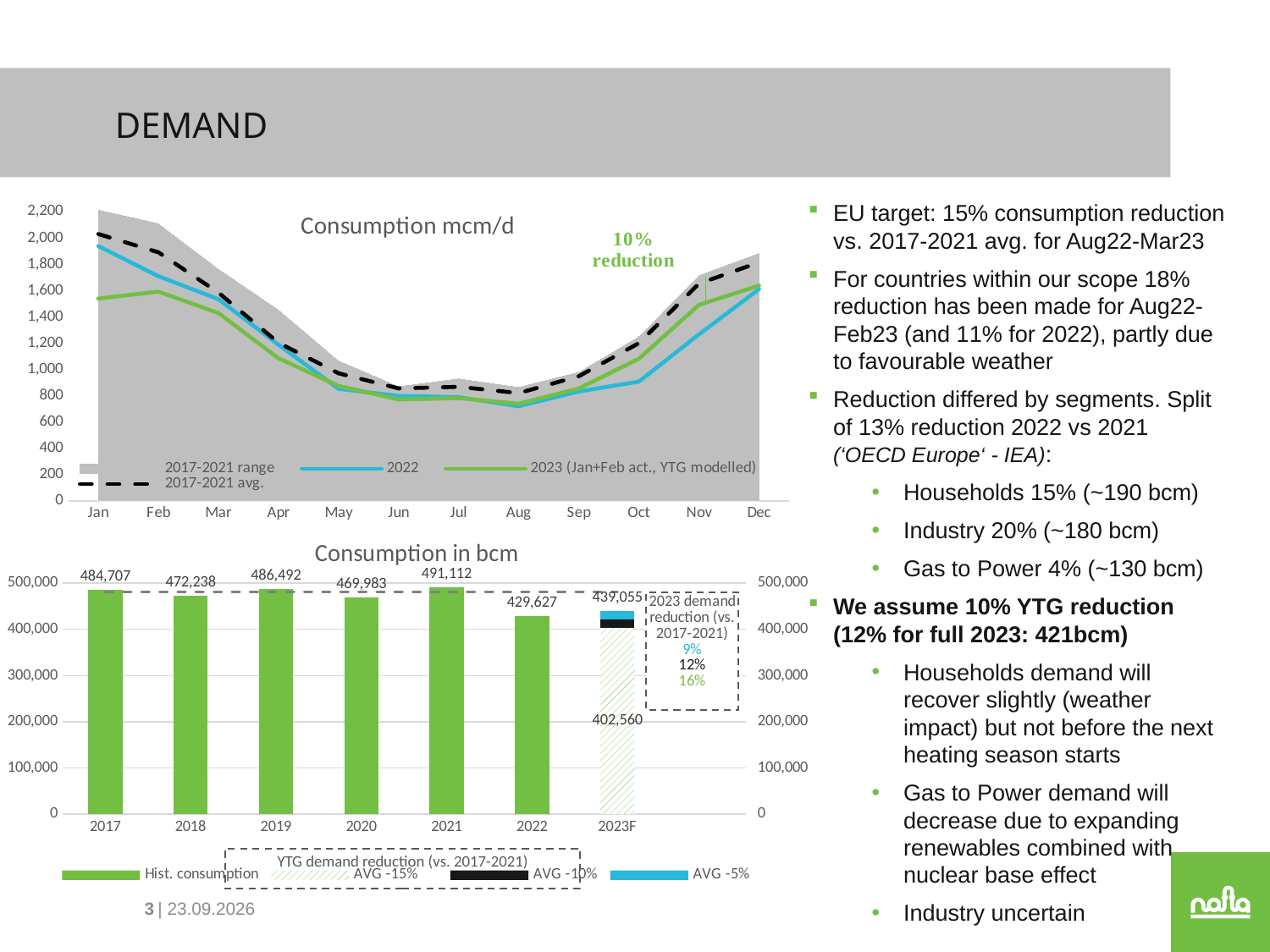
In the 'Consumption in bcm' chart, what is the value for 2022? 429,627 In the 'Consumption in bcm' chart, which year from 2017 to 2022 has the lowest consumption? 2022 How many year categories are shown on the x axis of the 'Consumption in bcm' chart? 7 In the 'Consumption mcm/d' chart, is the 2022 value for Jan greater or less than 1,800? greater In the 'Consumption in bcm' chart, what is the difference between the 2021 and 2022 values? 61,485 In the 'Consumption in bcm' chart, which is larger, the value for 2019 or the value for 2020? 2019 What kind of chart is the 'Consumption in bcm' chart? bar chart In the 'Consumption mcm/d' chart, does the 2022 line rise or fall from Jan to Aug? fall In the 'Consumption in bcm' chart, which year from 2017 to 2022 has the highest consumption? 2021 In the 'Consumption in bcm' chart, what is the value for 2021? 491,112 In the 'Consumption mcm/d' chart, is the 2022 value for Aug greater or less than 800? less How many entries does the legend of the 'Consumption in bcm' chart list? 4